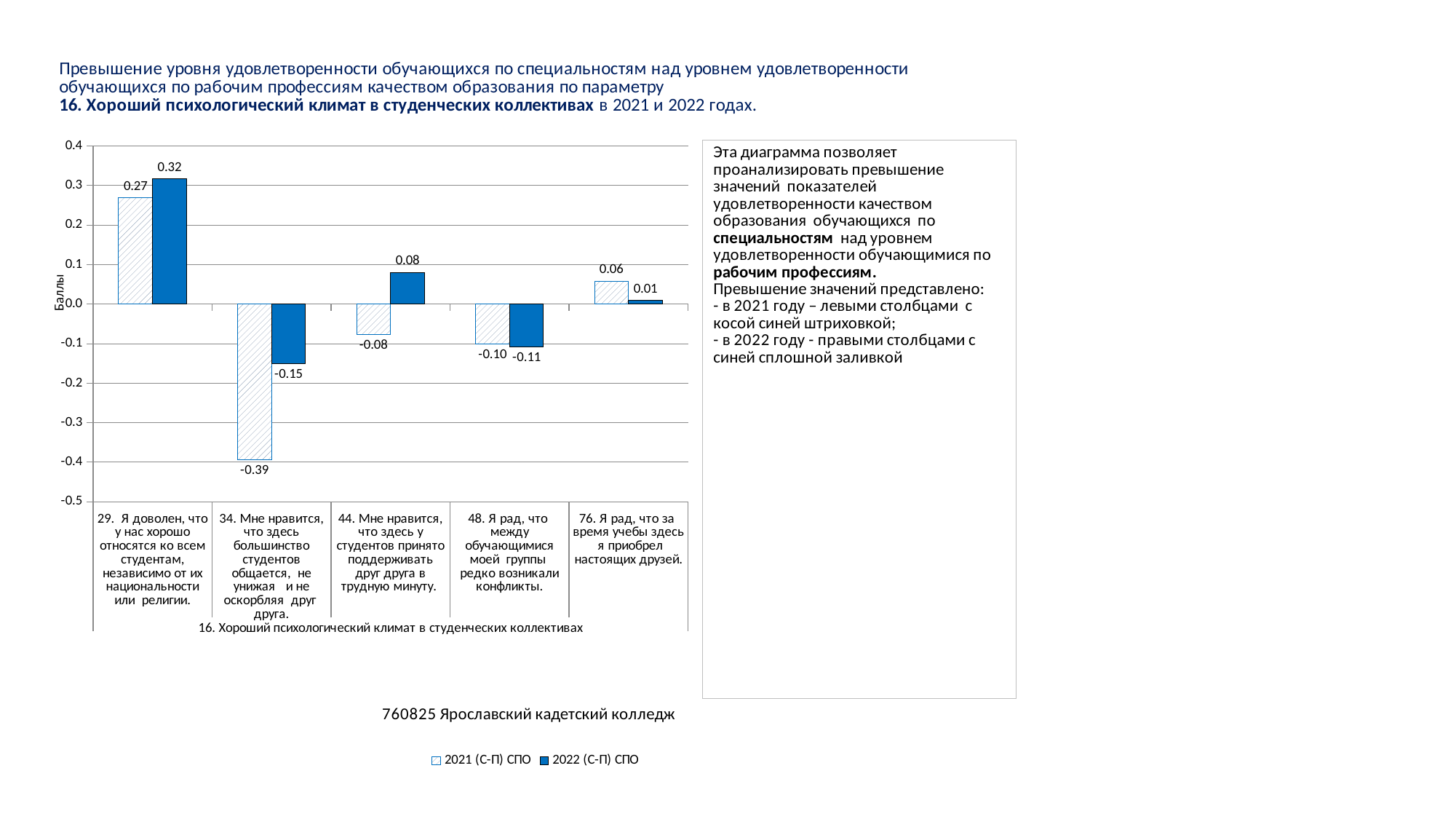
What type of chart is shown on the slide? Bar chart What is the value for 2022 (С-П) СПО for category 34 (Мне нравится, что здесь большинство студентов общается, не унижая и не оскорбляя друг друга)? -0.15 What is the difference between the 2022 and 2021 values for category 34? 0.24 Which category has the highest value for 2022 (С-П) СПО? 29. Я доволен, что у нас хорошо относятся ко всем студентам, независимо от их национальности или религии. What is the label of the y axis of the chart? Баллы How many series does the chart legend list? 2 For category 44 (Мне нравится, что здесь у студентов принято поддерживать друг друга в трудную минуту), which series has the larger value, 2021 (С-П) СПО or 2022 (С-П) СПО? 2022 (С-П) СПО What is the value for 2022 (С-П) СПО for category 76 (Я рад, что за время учебы здесь я приобрел настоящих друзей)? 0.01 Which category has the lowest value for 2021 (С-П) СПО? 34. Мне нравится, что здесь большинство студентов общается, не унижая и не оскорбляя друг друга. Which series is shown with solid blue fill according to the legend? 2022 (С-П) СПО How many categories are shown on the x axis of the chart? 5 What is the value for 2021 (С-П) СПО for category 29 (Я доволен, что у нас хорошо относятся ко всем студентам...)? 0.27